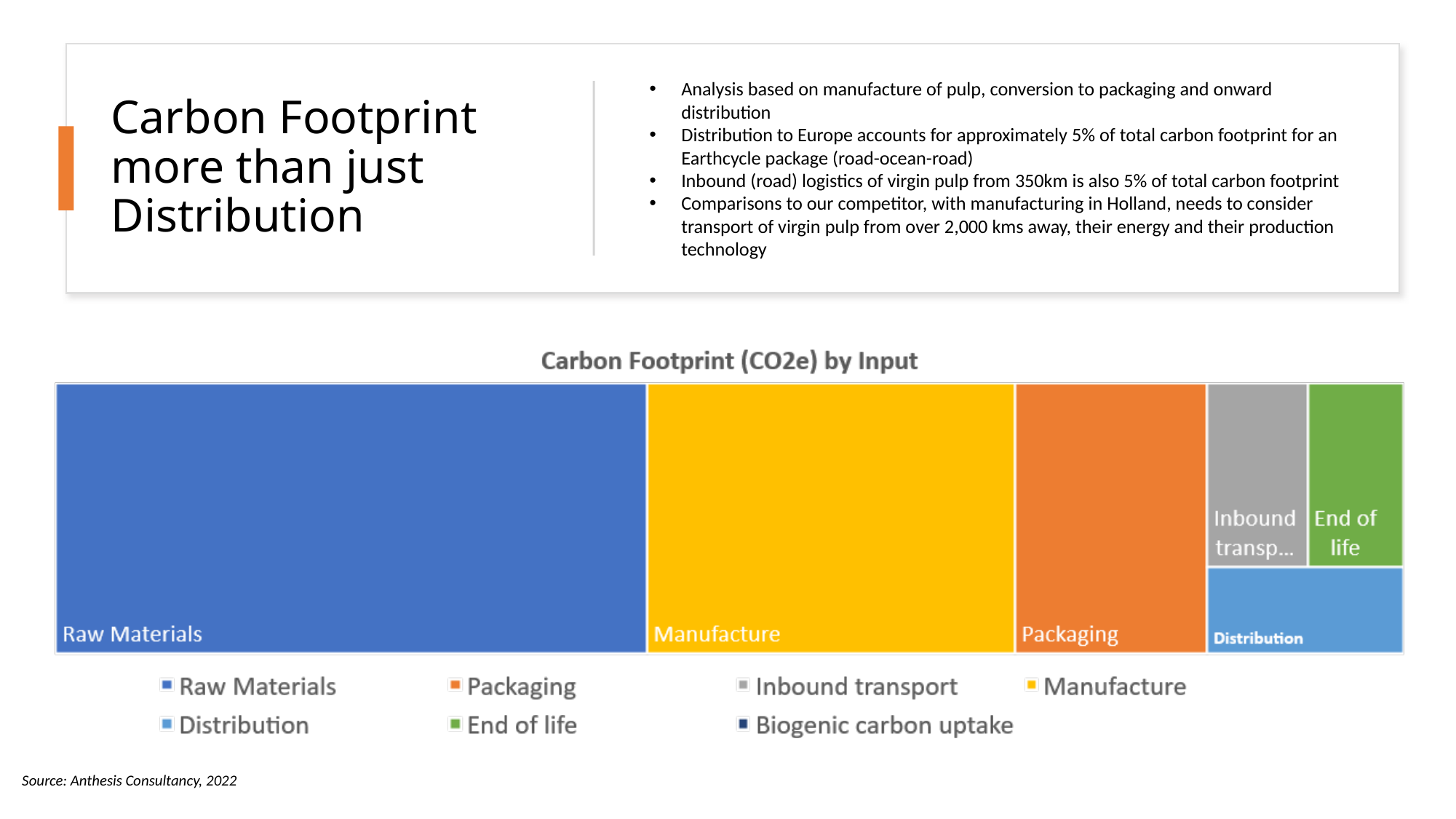
Which has the larger carbon footprint, Manufacture or Inbound transport? Manufacture Which has the larger carbon footprint, Raw Materials or Manufacture? Raw Materials How many entries does the chart legend list? 7 Which input has the largest carbon footprint in the chart? Raw Materials What is the title of the chart? Carbon Footprint (CO2e) by Input Which has the larger carbon footprint, Packaging or Distribution? Packaging What kind of chart is shown on the slide? Treemap How many labelled tiles are visible in the treemap? 6 What colour is the Manufacture tile in the chart? Yellow